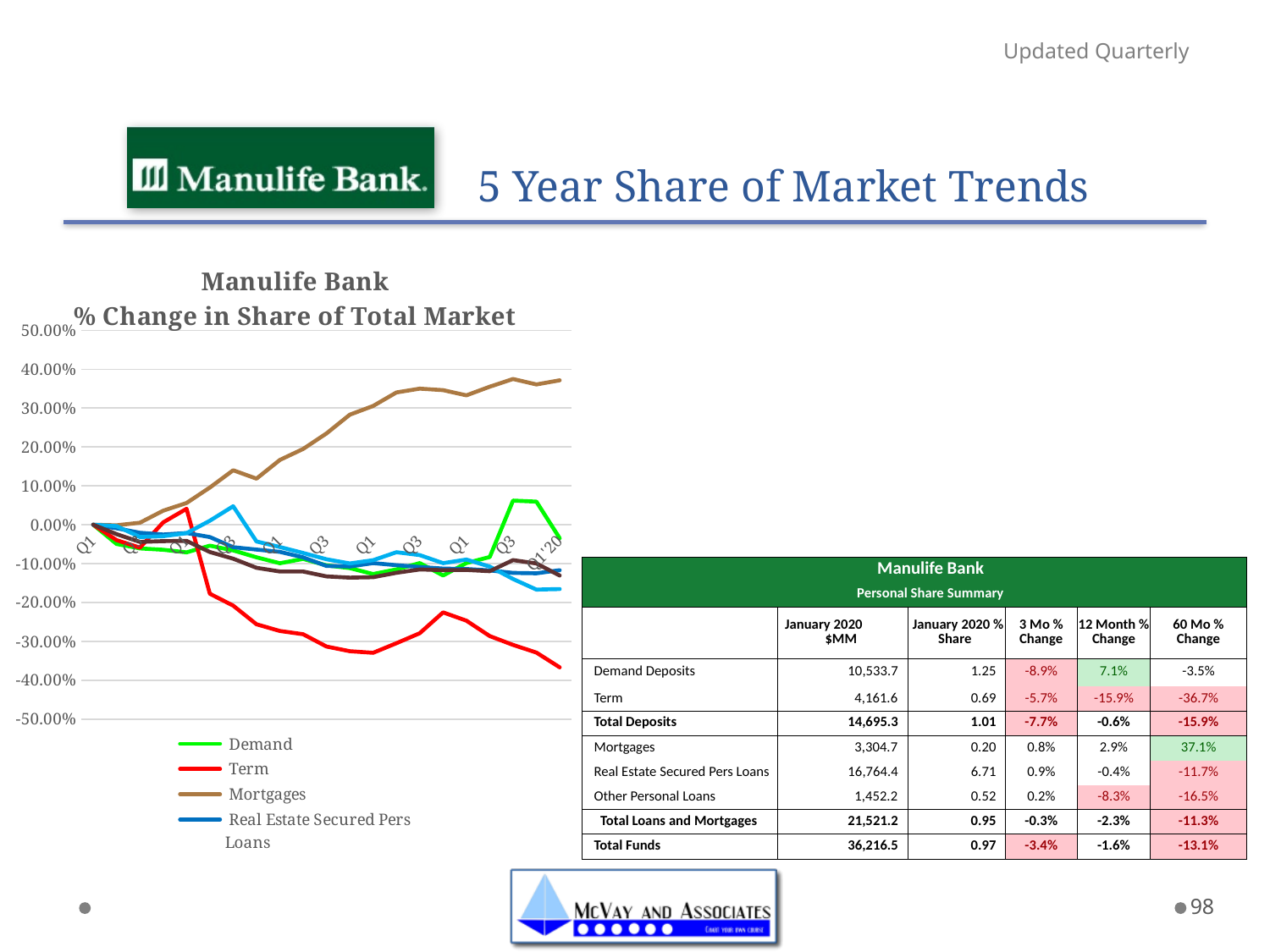
Is the value for Real Estate Secured Pers Loans at the last point (Q1'20) greater or less than 0.00%? less What is the title of the chart on the slide? Manulife Bank % Change in Share of Total Market Is the value for Term at the last point (Q1'20) greater or less than -30.00%? less What kind of chart is shown on the slide? line chart Does the Term line generally rise or fall from left to right across the chart? fall At the last point (Q1'20), which is larger: the value for Mortgages or the value for Demand? Mortgages Is the value for Mortgages at the last point (Q1'20) greater or less than 30.00%? greater Does the Mortgages line generally rise or fall from left to right across the chart? rise Which series is drawn in red on the chart? Term How many series does the legend of the chart list? 4 Which series has the highest value at the last point (Q1'20) on the chart? Mortgages Which series has the lowest value at the last point (Q1'20) on the chart? Term